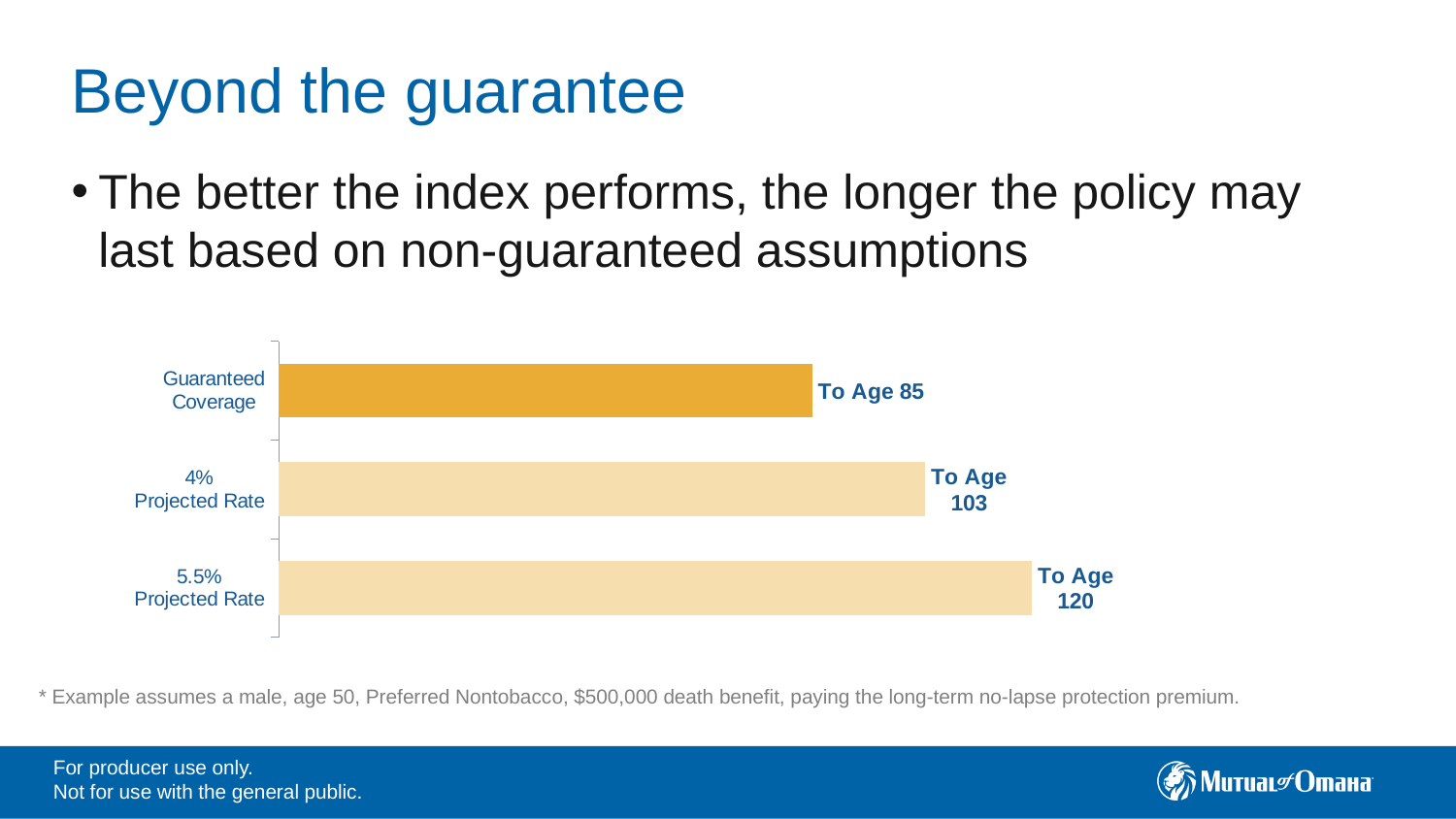
Do the bar values increase or decrease going from the top bar to the bottom bar? increase What is the data label for Guaranteed Coverage? To Age 85 Which category has the longest bar? 5.5% Projected Rate Which bar is drawn in a darker orange colour than the others? Guaranteed Coverage What is the data label for the 4% Projected Rate bar? To Age 103 Which lasts to a higher age, the 4% Projected Rate or the 5.5% Projected Rate? 5.5% Projected Rate How many years longer does coverage last at the 4% Projected Rate than under Guaranteed Coverage? 18 What is the data label for the 5.5% Projected Rate bar? To Age 120 How many years longer does coverage last at the 5.5% Projected Rate than under Guaranteed Coverage? 35 How many categories does the chart show? 3 What kind of chart is shown on the slide? bar chart Which category has the shortest bar? Guaranteed Coverage